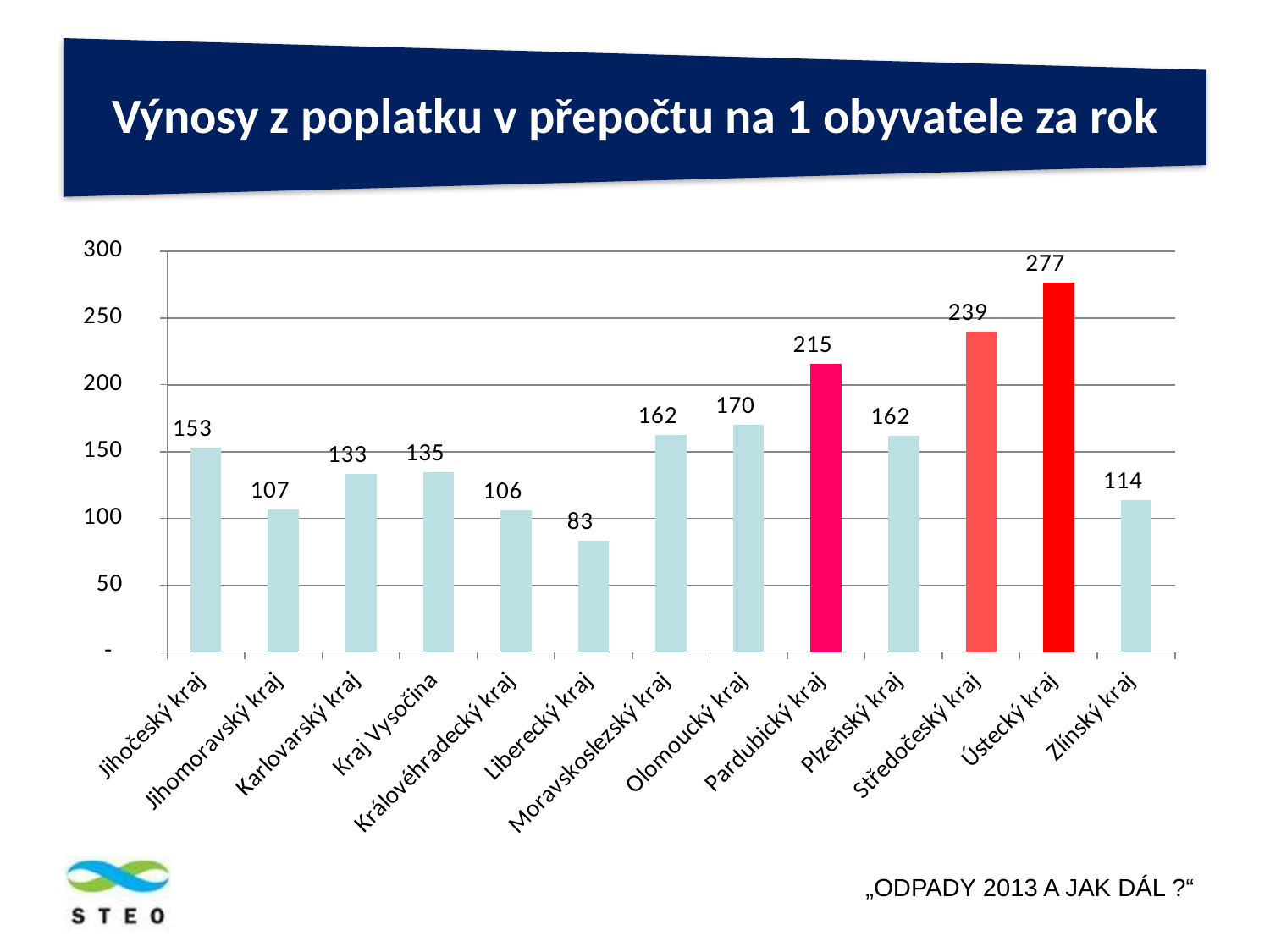
What kind of chart is shown on the slide? bar chart Which region has the lowest value? Liberecký kraj What is the title of the slide? Výnosy z poplatku v přepočtu na 1 obyvatele za rok What is the value for Jihočeský kraj? 153 Is the value for Kraj Vysočina greater or less than 150? less What is the value for Liberecký kraj? 83 What is the value for Středočeský kraj? 239 What is the difference between the values for Ústecký kraj and Pardubický kraj? 62 How many bars are coloured red or pink rather than light blue? 3 Which is larger, the value for Olomoucký kraj or the value for Plzeňský kraj? Olomoucký kraj How many regions are shown on the chart? 13 Which region has the highest value? Ústecký kraj